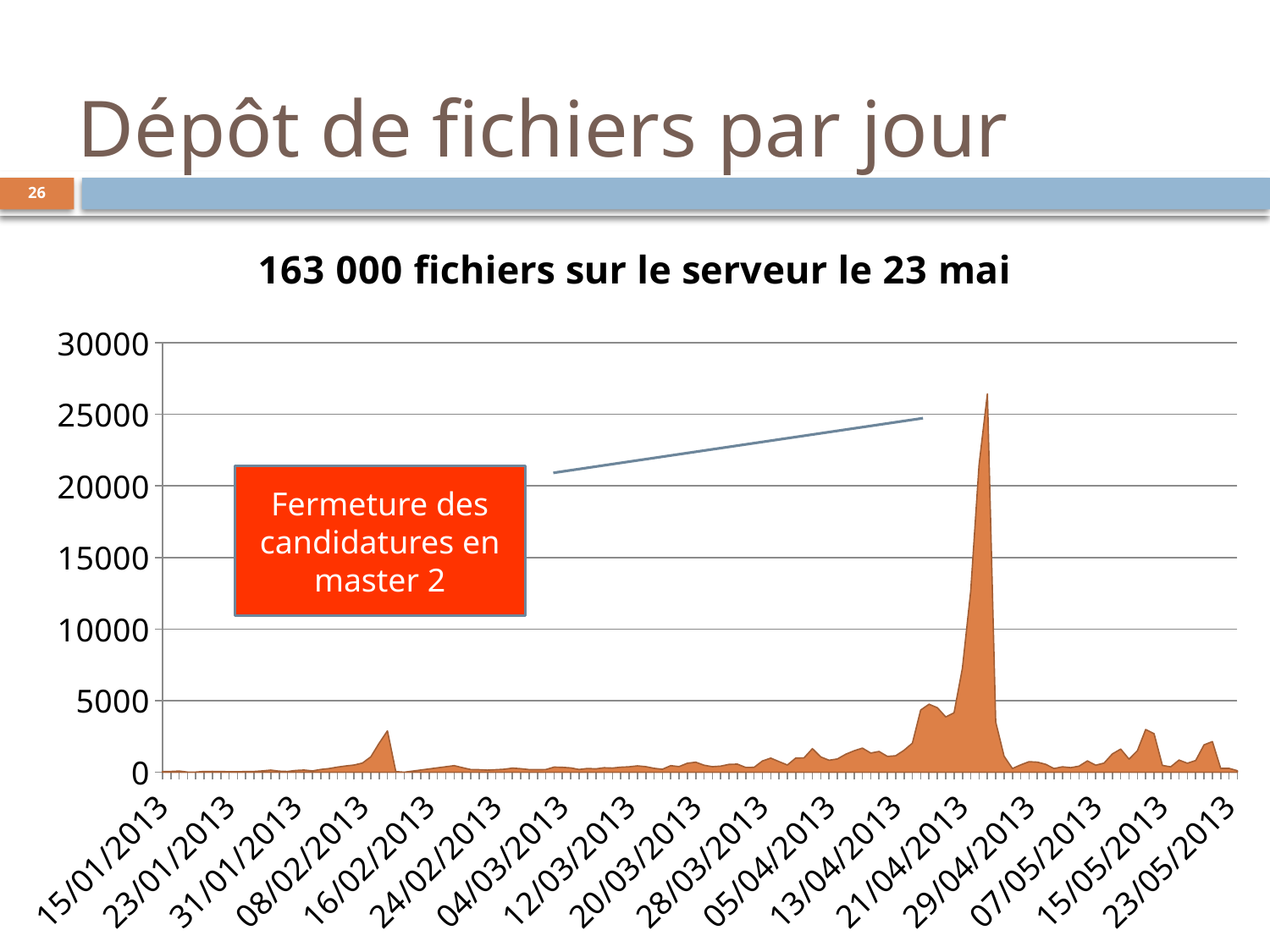
Between which two labeled dates on the x axis does the highest peak occur? 21/04/2013 and 29/04/2013 Is the highest peak of the chart greater or less than 30000? less Is the highest peak of the chart greater or less than 25000? greater What is the title of the chart? 163 000 fichiers sur le serveur le 23 mai What is the last date label on the x axis? 23/05/2013 Is the small peak just after 08/02/2013 greater or less than 5000? less What does the red annotation box on the chart say? Fermeture des candidatures en master 2 What is the first date label on the x axis? 15/01/2013 How many date labels are shown on the x axis? 17 What kind of chart is shown on the slide? area chart